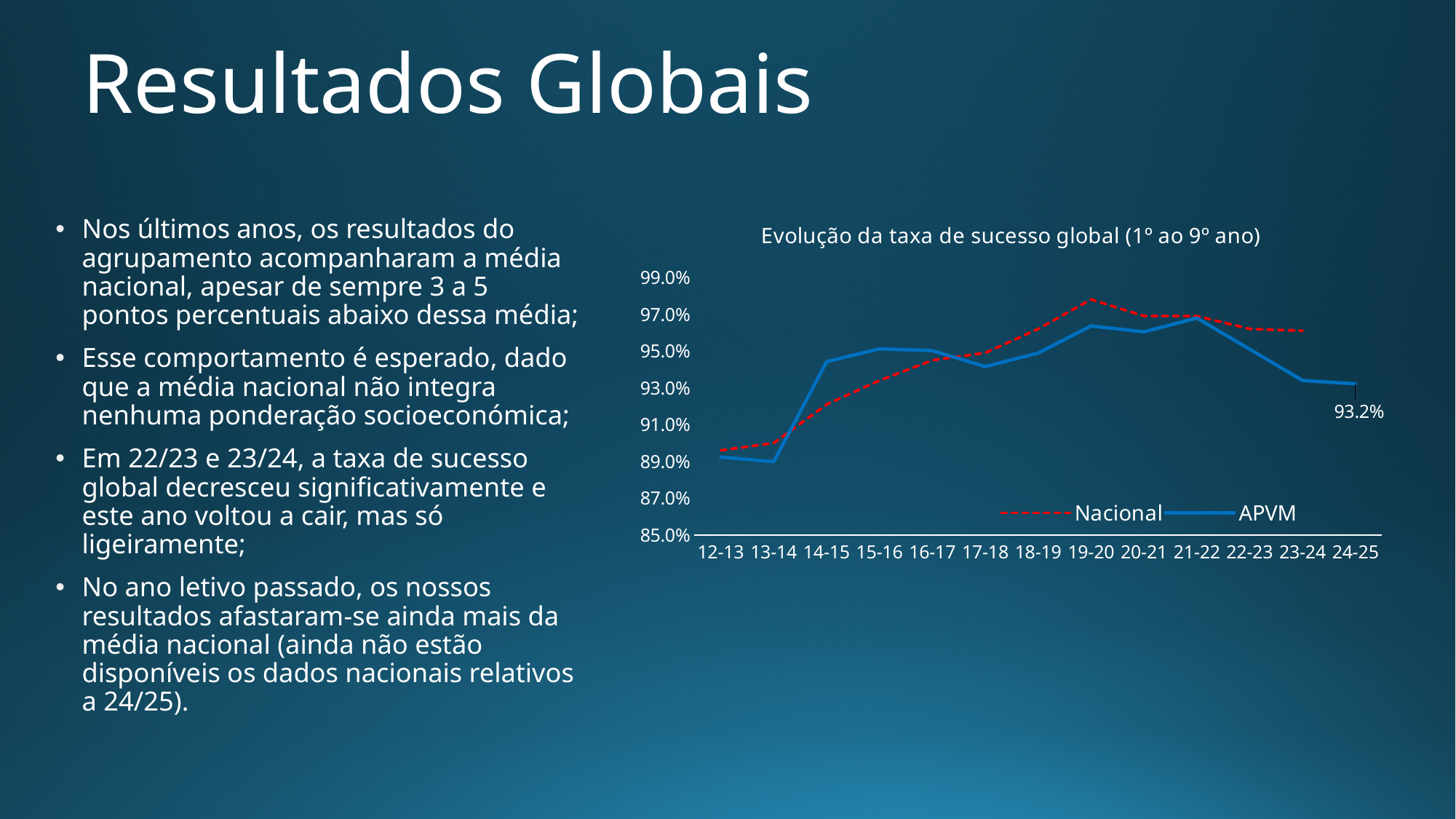
What is the APVM value for 24-25? 93.2% Does the APVM series rise or fall from 21-22 to 24-25? fall In 19-20, which series has the higher value, Nacional or APVM? Nacional Is the APVM value for 13-14 greater or less than 91.0%? less Is the Nacional value for 23-24 greater or less than 95.0%? greater In which school year does the APVM series reach its highest value? 21-22 Is the Nacional value for 19-20 greater or less than 97.0%? greater How many school years are shown along the x axis of the chart? 13 Which series is drawn as a red dashed line? Nacional What is the title of the chart? Evolução da taxa de sucesso global (1º ao 9º ano) How many series does the chart's legend list? 2 What kind of chart is shown on the slide? line chart